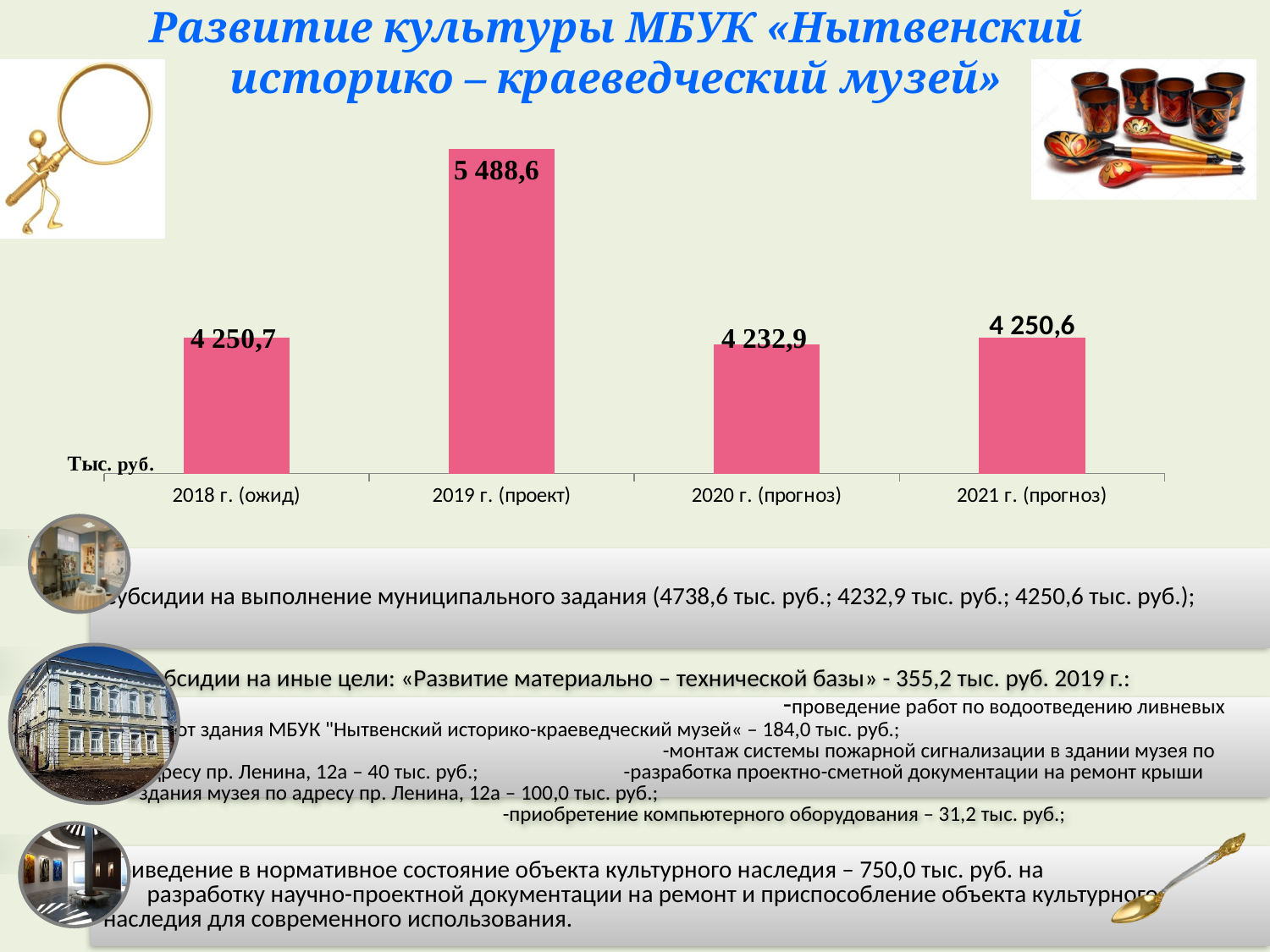
What is the difference between the values for 2019 г. (проект) and 2018 г. (ожид)? 1 237,9 What is the difference between the values for 2018 г. (ожид) and 2020 г. (прогноз)? 17,8 What is the value for 2018 г. (ожид) on the chart? 4 250,7 What kind of chart is shown on the slide? Bar chart What is the value for 2021 г. (прогноз) on the chart? 4 250,6 What unit is indicated for the values on the chart? Тыс. руб. What is the value for 2020 г. (прогноз) on the chart? 4 232,9 How many categories (years) are shown on the chart? 4 Which year has the highest value on the chart? 2019 г. (проект) Which is larger, the value for 2019 г. (проект) or the value for 2021 г. (прогноз)? 2019 г. (проект) What is the value for 2019 г. (проект) on the chart? 5 488,6 Which year has the lowest value on the chart? 2020 г. (прогноз)